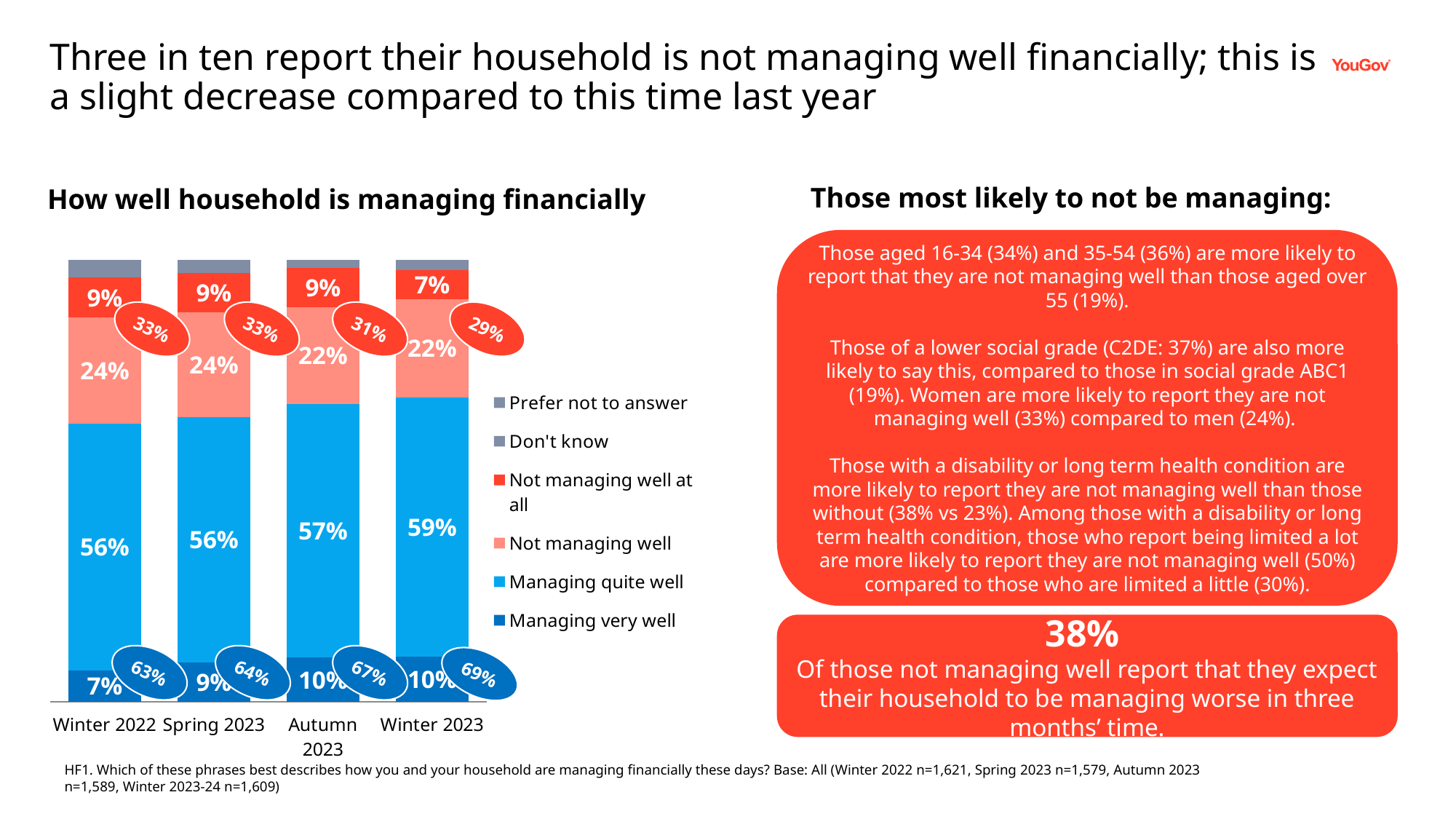
In which period was the 'Managing quite well' share highest? Winter 2023 What percentage of households were 'Not managing well at all' in Winter 2023? 7% What percentage of households were 'Managing quite well' in Winter 2023? 59% What percentage of households were 'Not managing well' in Autumn 2023? 22% Does the 'Managing quite well' share rise or fall from Winter 2022 to Winter 2023? rise What is the difference between the 'Not managing well' share in Winter 2022 and in Winter 2023? 2 percentage points What percentage of households were 'Managing very well' in Winter 2022? 7% What kind of chart is shown under the heading 'How well household is managing financially'? stacked bar chart In which period was the 'Managing very well' share lowest? Winter 2022 What is the combined share of 'Managing very well' and 'Managing quite well' in Winter 2023, as shown in the blue oval? 69% How many time periods are shown along the x axis of the chart? 4 How many series does the legend of the chart list? 6